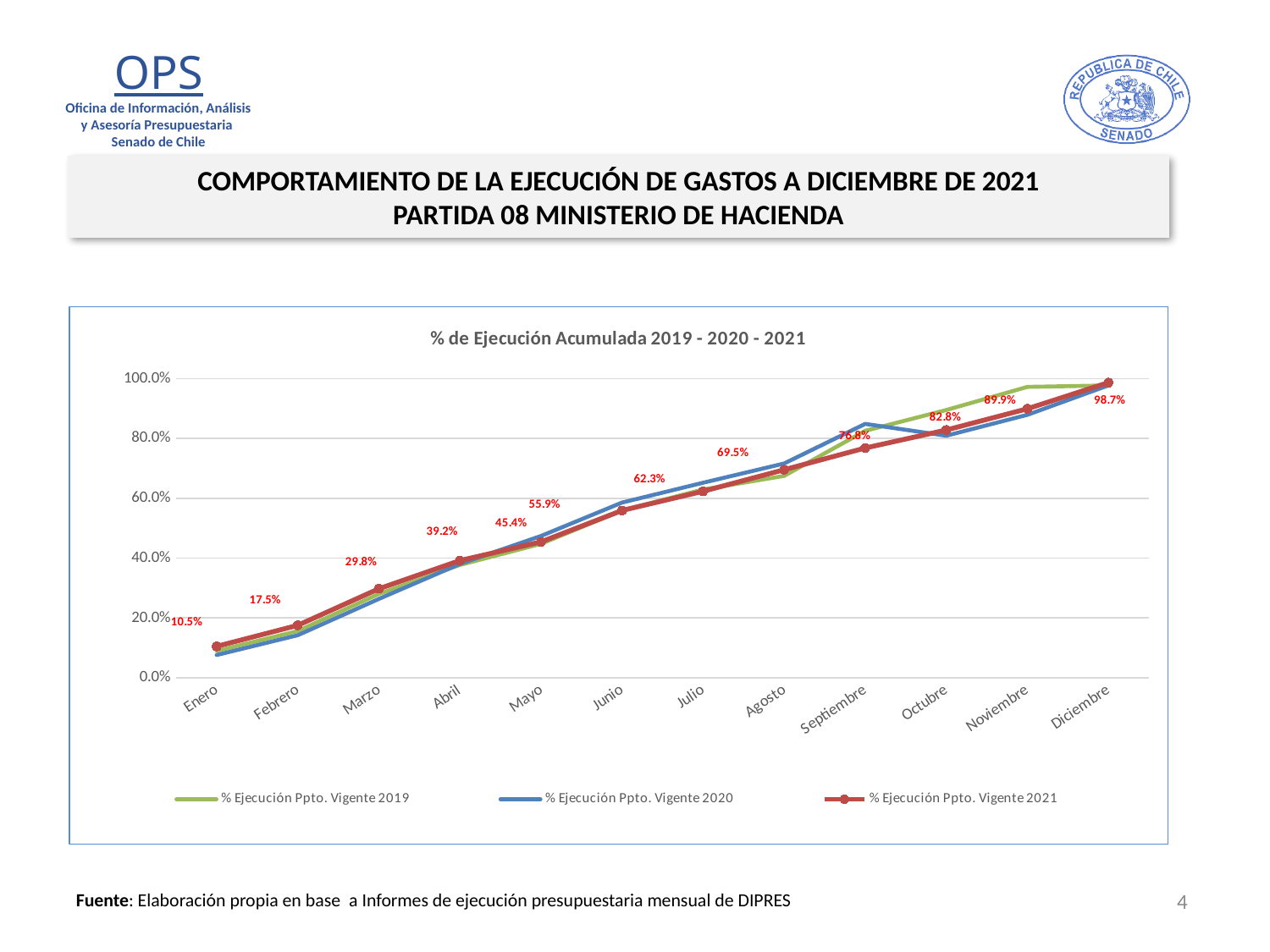
How many series does the legend list? 3 How many months are shown on the x axis? 12 What is the value for % Ejecución Ppto. Vigente 2021 in Junio? 55.9% Does the % Ejecución Ppto. Vigente 2021 series rise or fall from Enero to Diciembre? rise In which month is the % Ejecución Ppto. Vigente 2021 series lowest? Enero What is the value for % Ejecución Ppto. Vigente 2021 in Diciembre? 98.7% What type of chart is shown on the slide? line chart In which month is the % Ejecución Ppto. Vigente 2021 series highest? Diciembre What is the value for % Ejecución Ppto. Vigente 2021 in Enero? 10.5% Is the value for % Ejecución Ppto. Vigente 2020 in Septiembre greater or less than 80.0%? greater What is the title of the chart? % de Ejecución Acumulada 2019 - 2020 - 2021 What is the difference between the % Ejecución Ppto. Vigente 2021 values for Diciembre and Noviembre? 8.8%